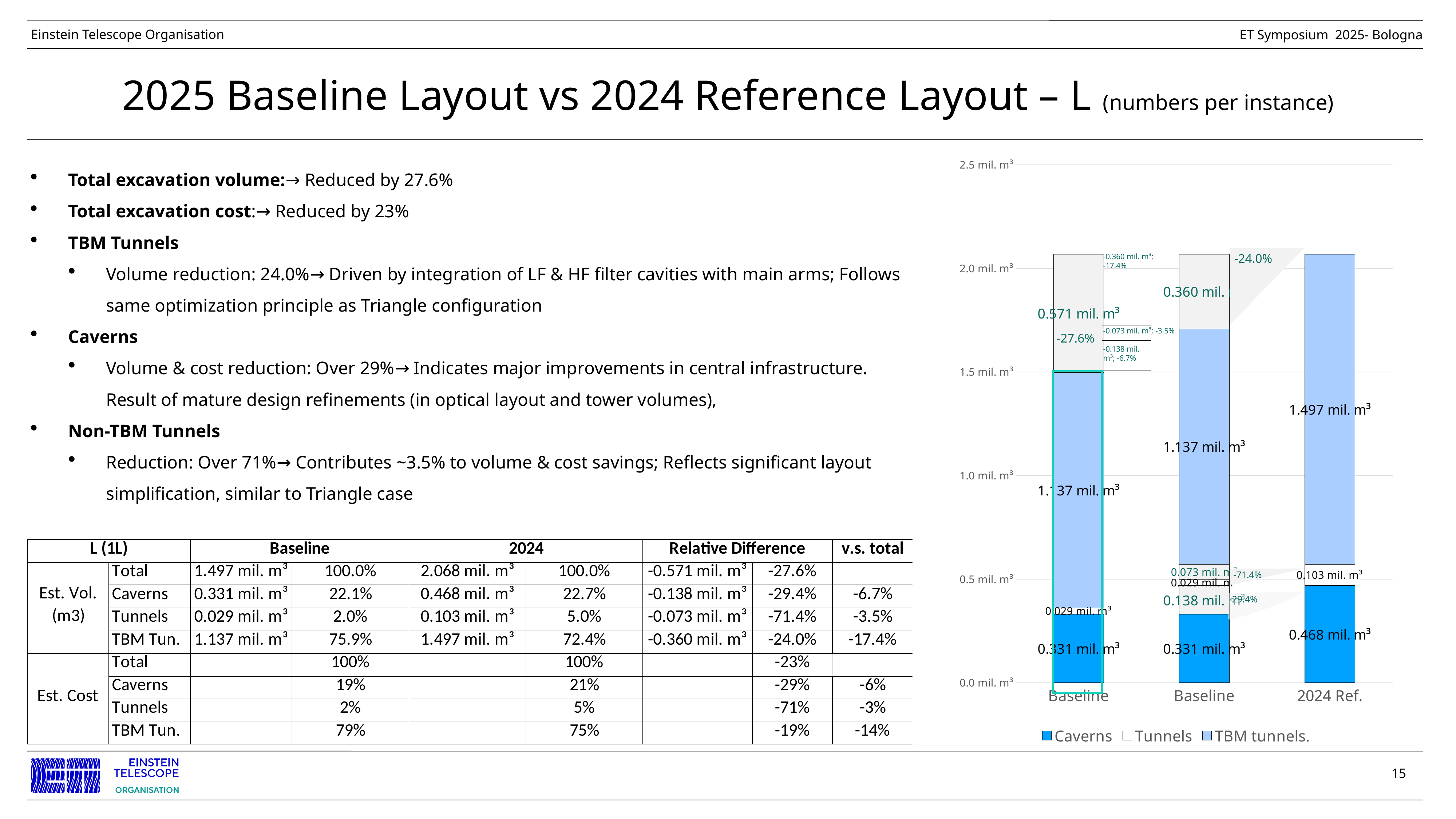
What is the TBM tunnels value for the middle Baseline bar? 1.137 mil. m³ Which bar has the larger TBM tunnels value, the middle Baseline bar or the 2024 Ref. bar? 2024 Ref. How many bars are plotted in the chart? 3 Which segment is the largest in the 2024 Ref. bar? TBM tunnels How many series does the chart legend list? 3 What is the Tunnels value for the 2024 Ref. bar? 0.103 mil. m³ What kind of chart is shown on the right of the slide? bar chart What is the Caverns value for the 2024 Ref. bar? 0.468 mil. m³ What is the total of the 2024 Ref. stacked bar? 2.068 mil. m³ What is the TBM tunnels value for the 2024 Ref. bar? 1.497 mil. m³ What is the difference between the TBM tunnels value of the 2024 Ref. bar and that of the middle Baseline bar? 0.360 mil. m³ What is the Caverns value for the middle Baseline bar? 0.331 mil. m³